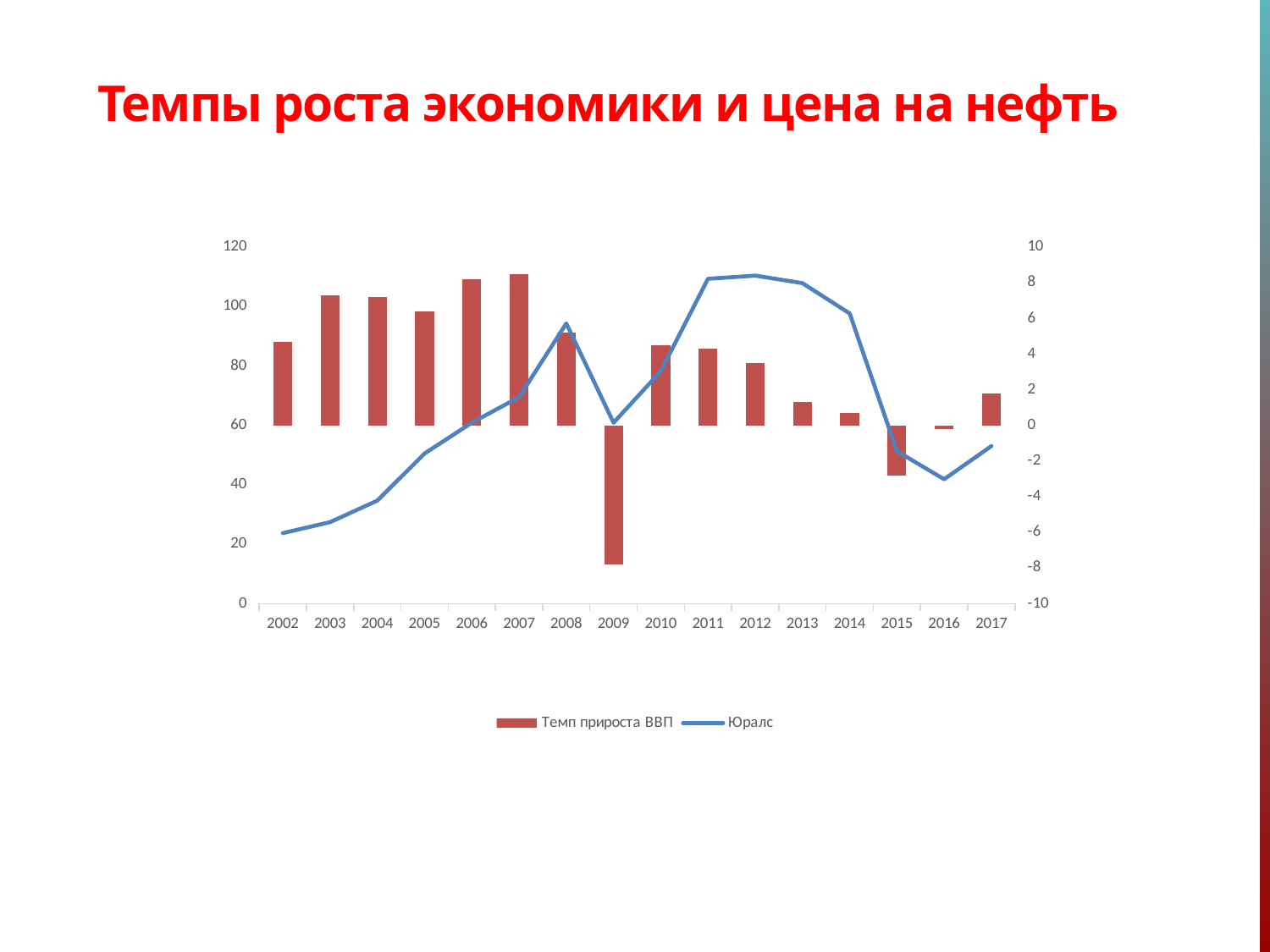
How many years are shown on the x axis of the chart? 16 In which year is the bar for Темп прироста ВВП the lowest? 2009 Which is larger, the Темп прироста ВВП bar for 2007 or for 2013? 2007 In which year is the Юралс line at its lowest? 2002 Does the Юралс line rise or fall from 2002 to 2008? rise Is the value for Темп прироста ВВП in 2009 greater or less than 0? less What kind of chart is shown on the slide? A combined bar and line chart What is the title of the slide? Темпы роста экономики и цена на нефть How many series does the legend list? 2 Which series is drawn as a line? Юралс Is the value for Юралс in 2012 greater or less than 100? greater In which year is the bar for Темп прироста ВВП the highest? 2007